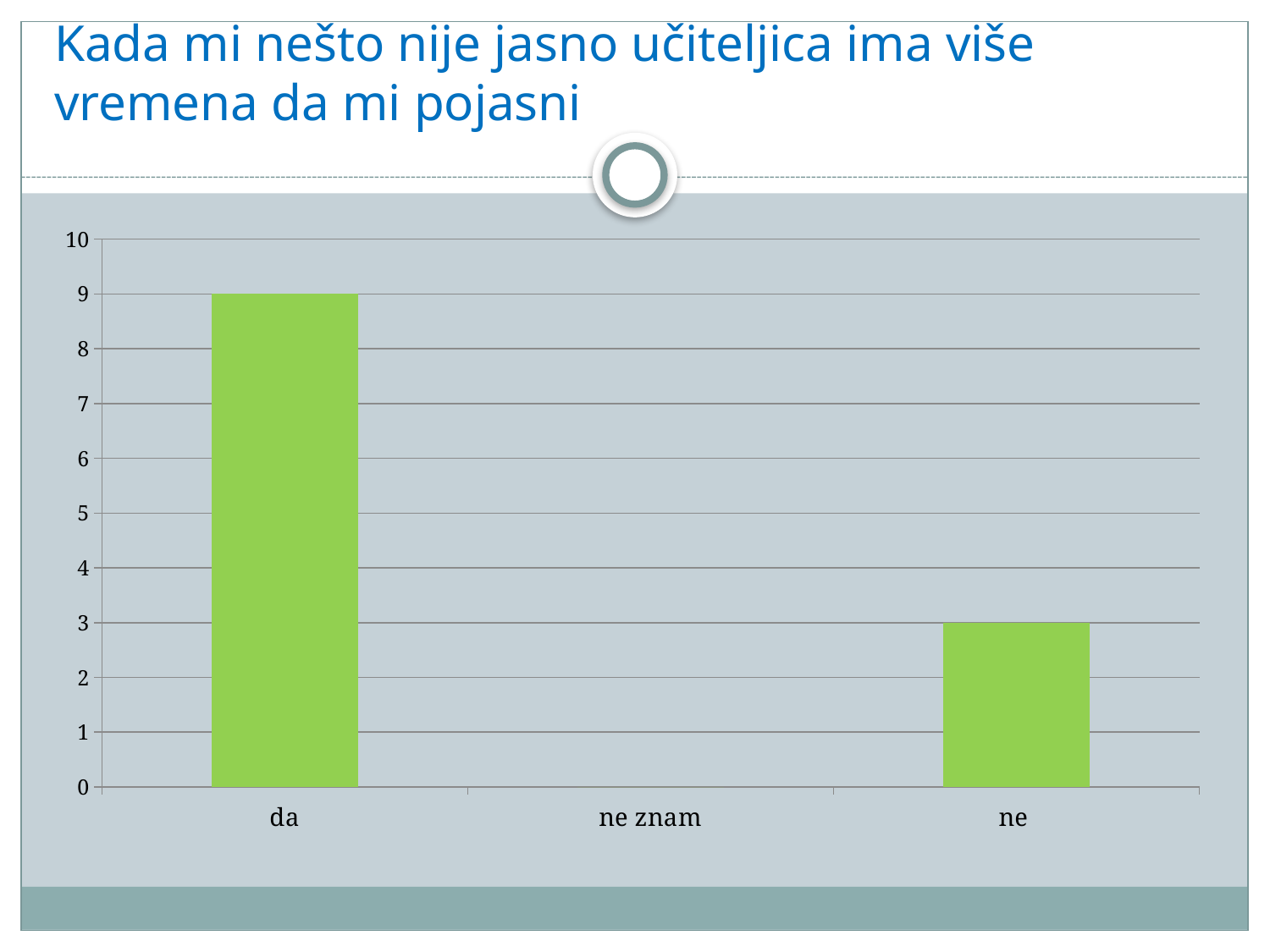
What is the maximum value shown on the y axis? 10 Is the value for "da" greater or less than 5? greater What colour are the bars in the chart? green Which is larger, the value for "da" or the value for "ne"? da What is the value for "ne znam"? 0 Which category has the highest value? da What is the difference between the values for "da" and "ne"? 6 What is the value for "da"? 9 Which category has the lowest value? ne znam How many categories are shown on the x axis of the chart? 3 What is the value for "ne"? 3 What kind of chart is shown on the slide? bar chart